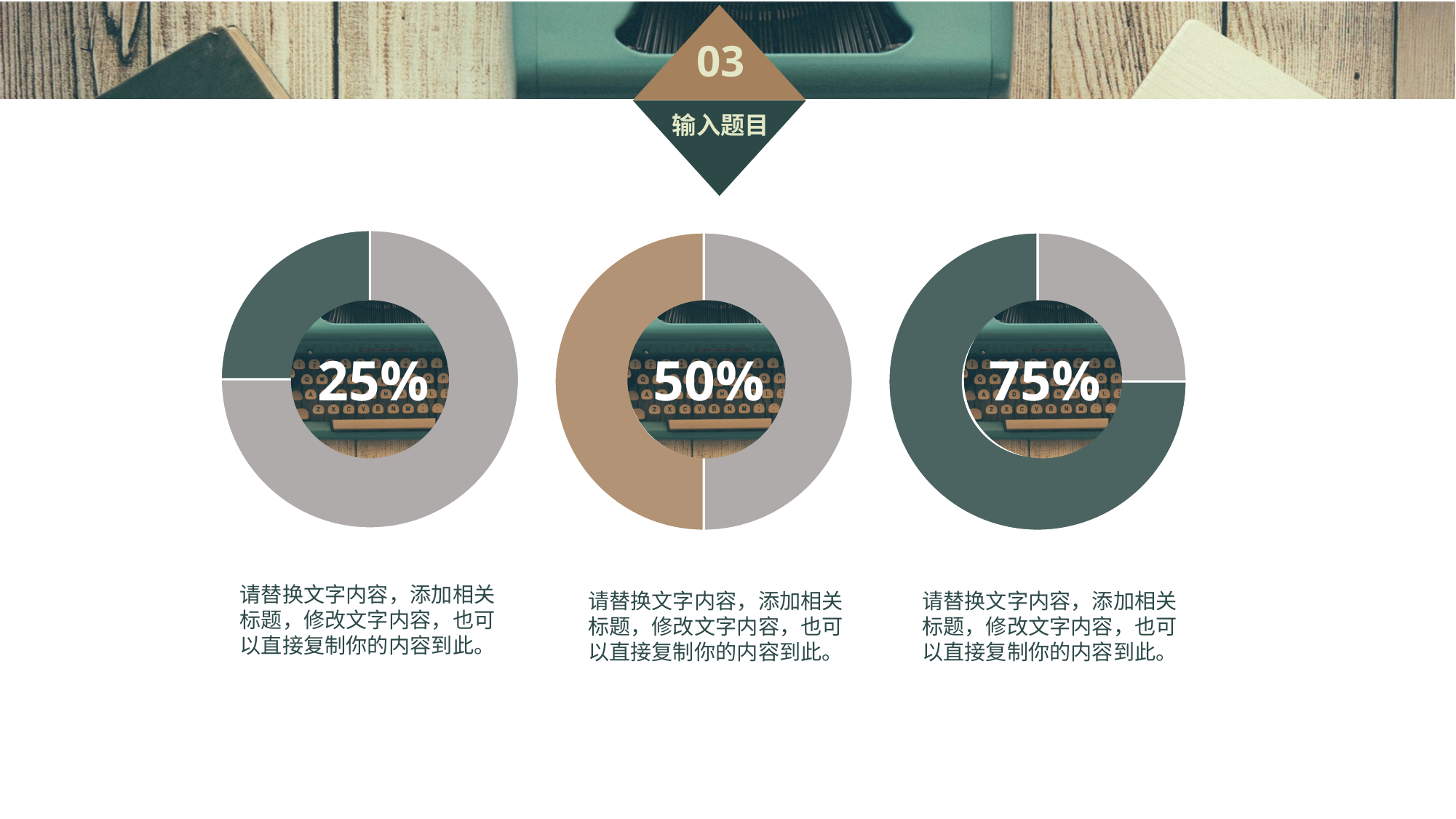
What colour is the filled portion of the middle donut chart? Brown Which is larger, the percentage in the middle donut chart or the percentage in the left donut chart? Middle What percentage is shown in the centre of the middle donut chart? 50% Do the percentages in the donut charts rise or fall from left to right across the slide? Rise Which donut chart shows the highest percentage: left, middle or right? Right How many donut charts are on the slide? 3 What percentage is shown in the centre of the right donut chart? 75% What percentage is shown in the centre of the left donut chart? 25% What is the difference between the percentage in the right donut chart and the percentage in the left donut chart? 50% What colour is the filled portion of the right donut chart? Dark green What kind of chart is used for the three figures on the slide? Donut chart Which donut chart shows the lowest percentage: left, middle or right? Left